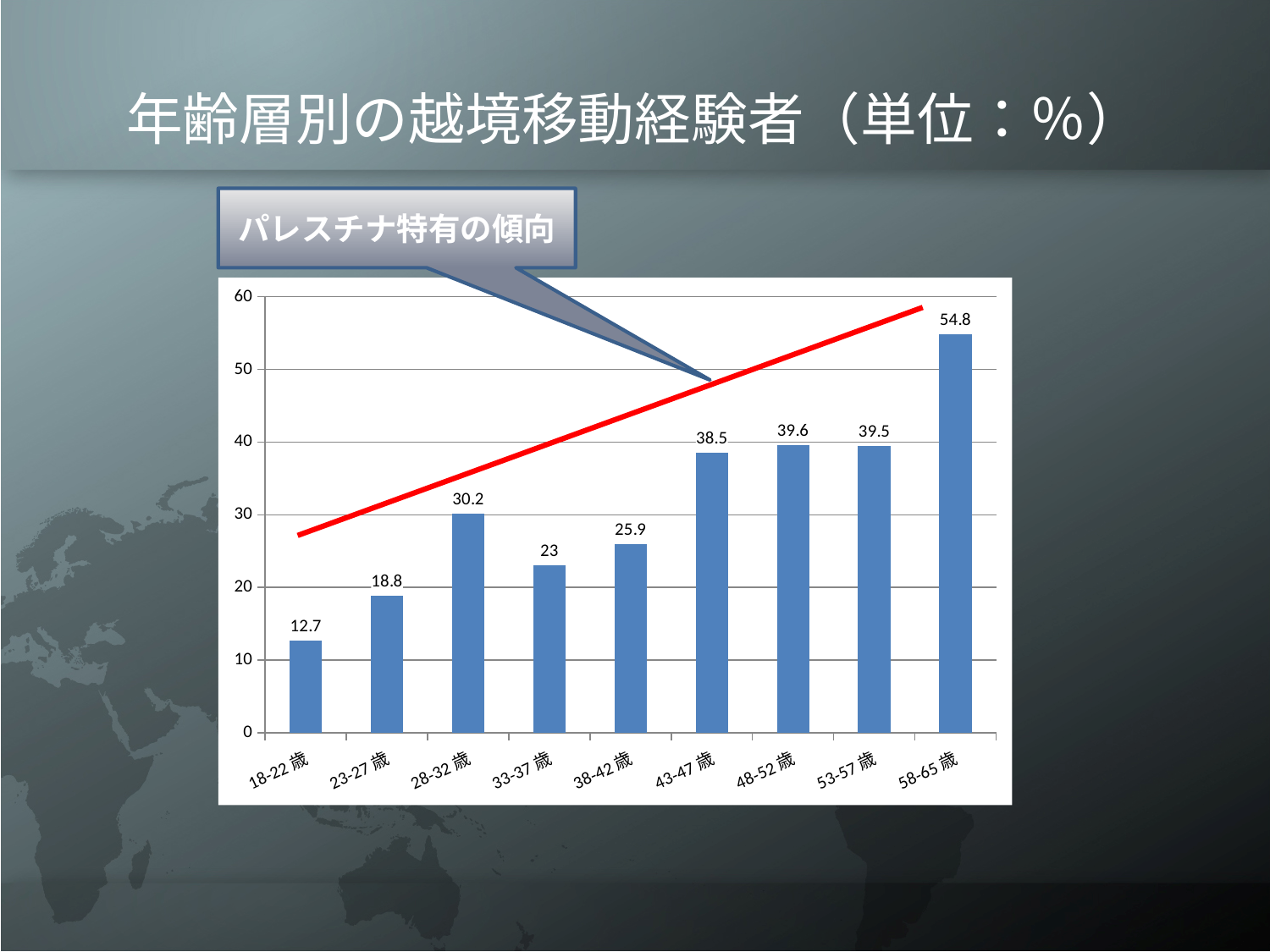
Is the value for 43-47歳 greater or less than 30? greater Which age group has the lowest value? 18-22歳 Which age group has the highest value? 58-65歳 Do the values generally rise or fall from the youngest to the oldest age group? rise What is the value for the 58-65歳 age group? 54.8 Which is larger, the value for 28-32歳 or the value for 38-42歳? 28-32歳 What is the difference between the values for 58-65歳 and 53-57歳? 15.3 How many age groups are shown on the x axis? 9 What is the value for the 33-37歳 age group? 23 What kind of chart is shown on the slide? bar chart What is the value for the 28-32歳 age group? 30.2 What does the callout box above the chart say? パレスチナ特有の傾向